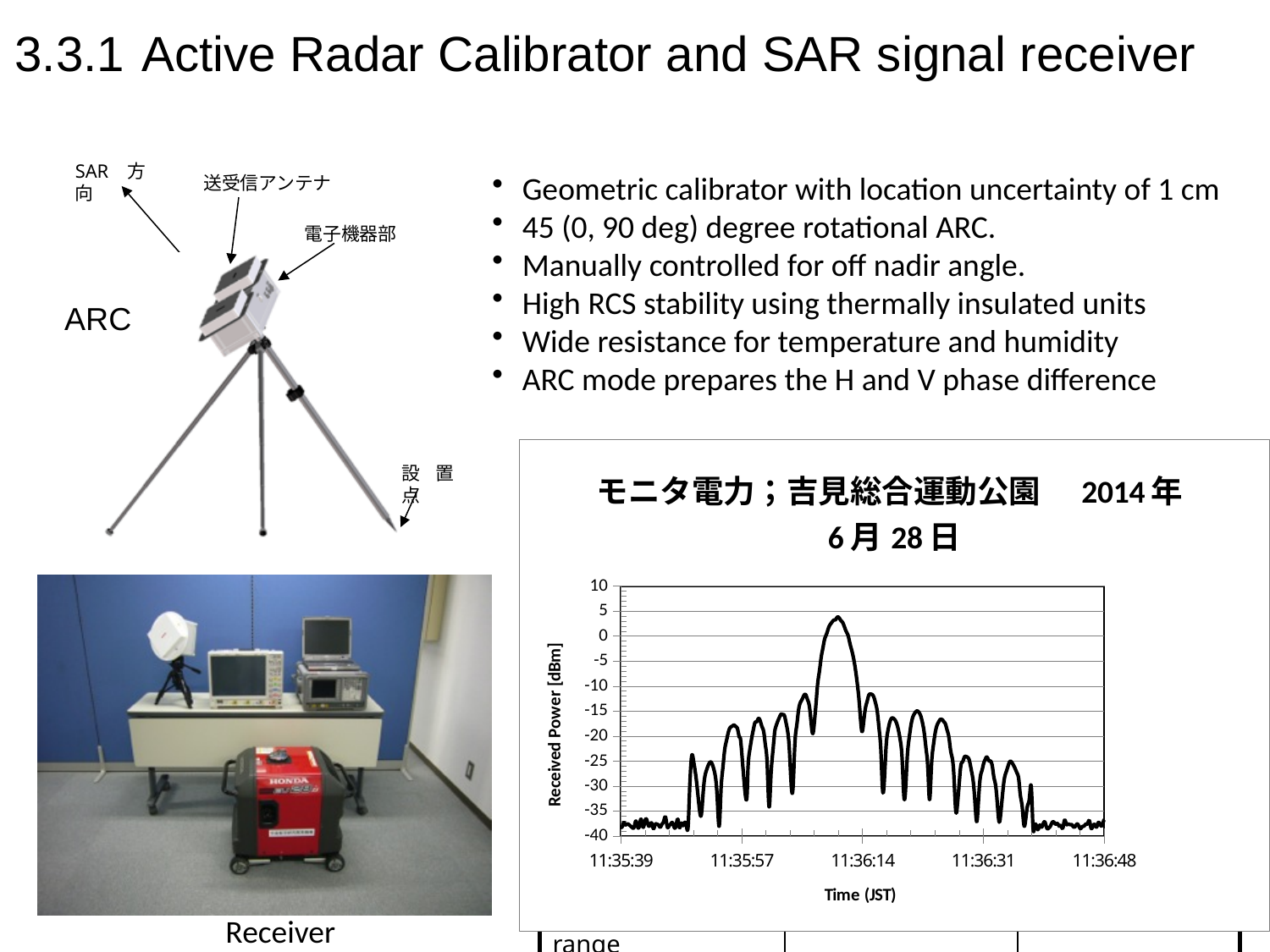
Is the received power at 11:35:39 greater or less than -35 dBm? less Is the peak received power in the chart greater or less than 0 dBm? greater How many time labels are printed along the x axis of the chart? 5 What is the title of the chart on the slide? モニタ電力；吉見総合運動公園 2014年6月28日 What kind of chart is shown on the slide? line chart What is the label of the vertical axis of the chart? Received Power [dBm] Is the received power at 11:35:57 greater or less than the received power at 11:35:39? greater Is the received power at 11:35:39 greater or less than -40 dBm? greater What is the highest value shown on the vertical axis of the chart? 10 What is the lowest value shown on the vertical axis of the chart? -40